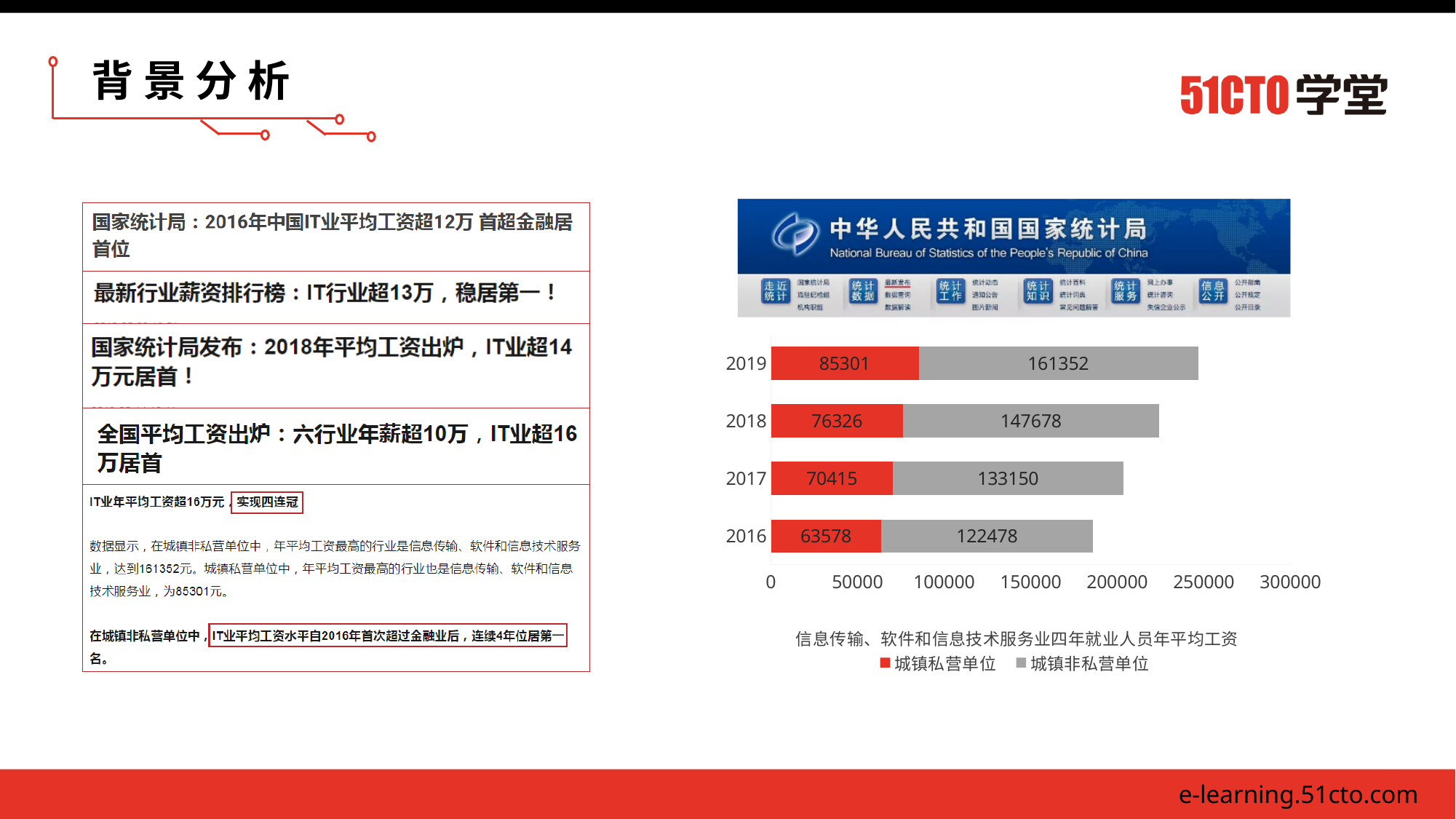
What kind of chart is shown on the slide? Stacked bar chart How many series does the legend list? 2 What is the total of the stacked bar for 2018? 224004 Which year has the highest value for 城镇非私营单位? 2019 How many years are shown on the chart? 4 What is the value for 城镇非私营单位 in 2017? 133150 Which is larger: 城镇私营单位 in 2018 or 城镇私营单位 in 2017? 城镇私营单位 in 2018 What is the difference between 城镇非私营单位 and 城镇私营单位 in 2019? 76051 Which year has the lowest value for 城镇私营单位? 2016 What is the value for 城镇私营单位 in 2016? 63578 What is the value for 城镇私营单位 in 2019? 85301 What is the total of the stacked bar for 2016? 186056